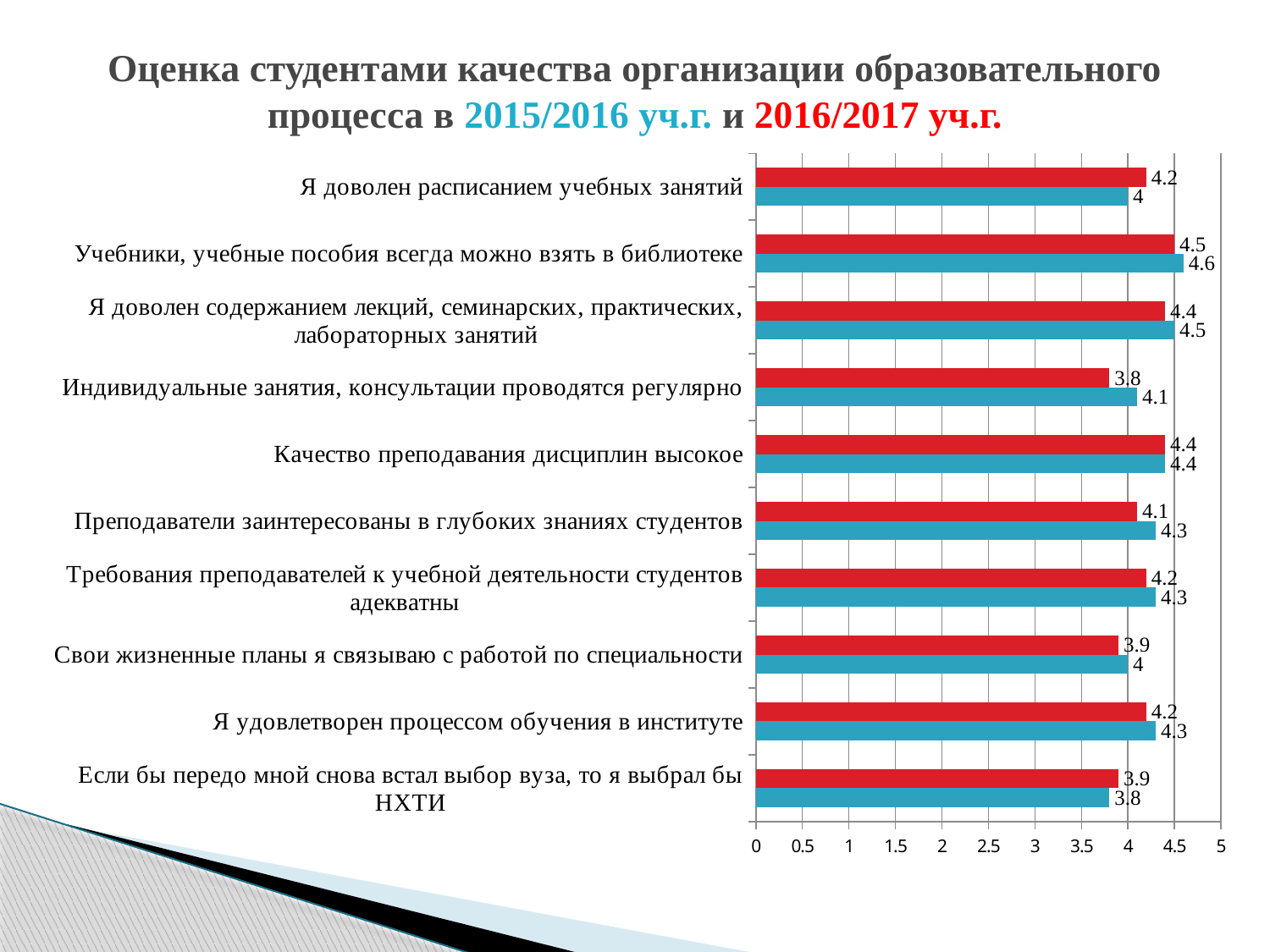
Which category has the lowest red bar value? Индивидуальные занятия, консультации проводятся регулярно What is the value of the blue bar for "Учебники, учебные пособия всегда можно взять в библиотеке"? 4.6 What is the difference between the blue and red bar values for "Индивидуальные занятия, консультации проводятся регулярно"? 0.3 Which category has the highest blue bar value? Учебники, учебные пособия всегда можно взять в библиотеке What is the value of the red bar for "Я доволен расписанием учебных занятий"? 4.2 Which two academic years are compared in the chart title? 2015/2016 уч.г. and 2016/2017 уч.г. What is the value of the red bar for "Индивидуальные занятия, консультации проводятся регулярно"? 3.8 Is the blue bar value for "Свои жизненные планы я связываю с работой по специальности" greater or less than 4.5? less For "Если бы передо мной снова встал выбор вуза, то я выбрал бы НХТИ", which bar is larger, red or blue? red What kind of chart is shown on the slide? bar chart What are the red and blue bar values for "Качество преподавания дисциплин высокое"? 4.4 and 4.4 How many categories (statements) are plotted on the chart? 10